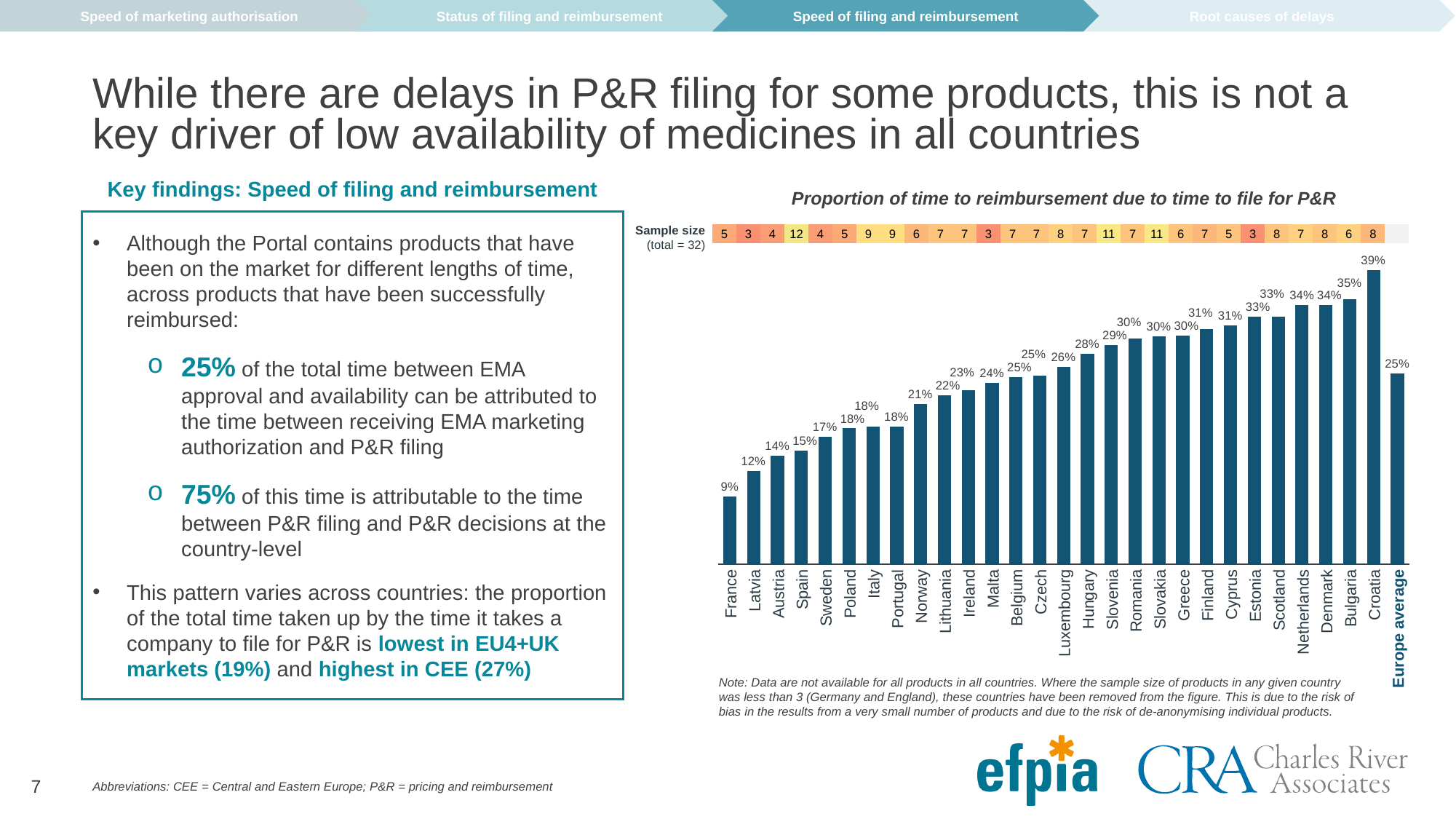
Which has a larger value, Bulgaria or Latvia? Bulgaria What kind of chart is shown? Bar chart What is the value shown for Europe average? 25% Do the country values rise or fall from left to right along the x axis? Rise Which country has the highest proportion? Croatia What is the value for France? 9% What is the sample size shown above the bar for Spain? 12 What is the value for Hungary? 28% What is the value for Croatia? 39% Which country has the lowest proportion? France What is the difference between the values for Croatia and France? 30% How many bars are plotted in the chart, including Europe average? 29